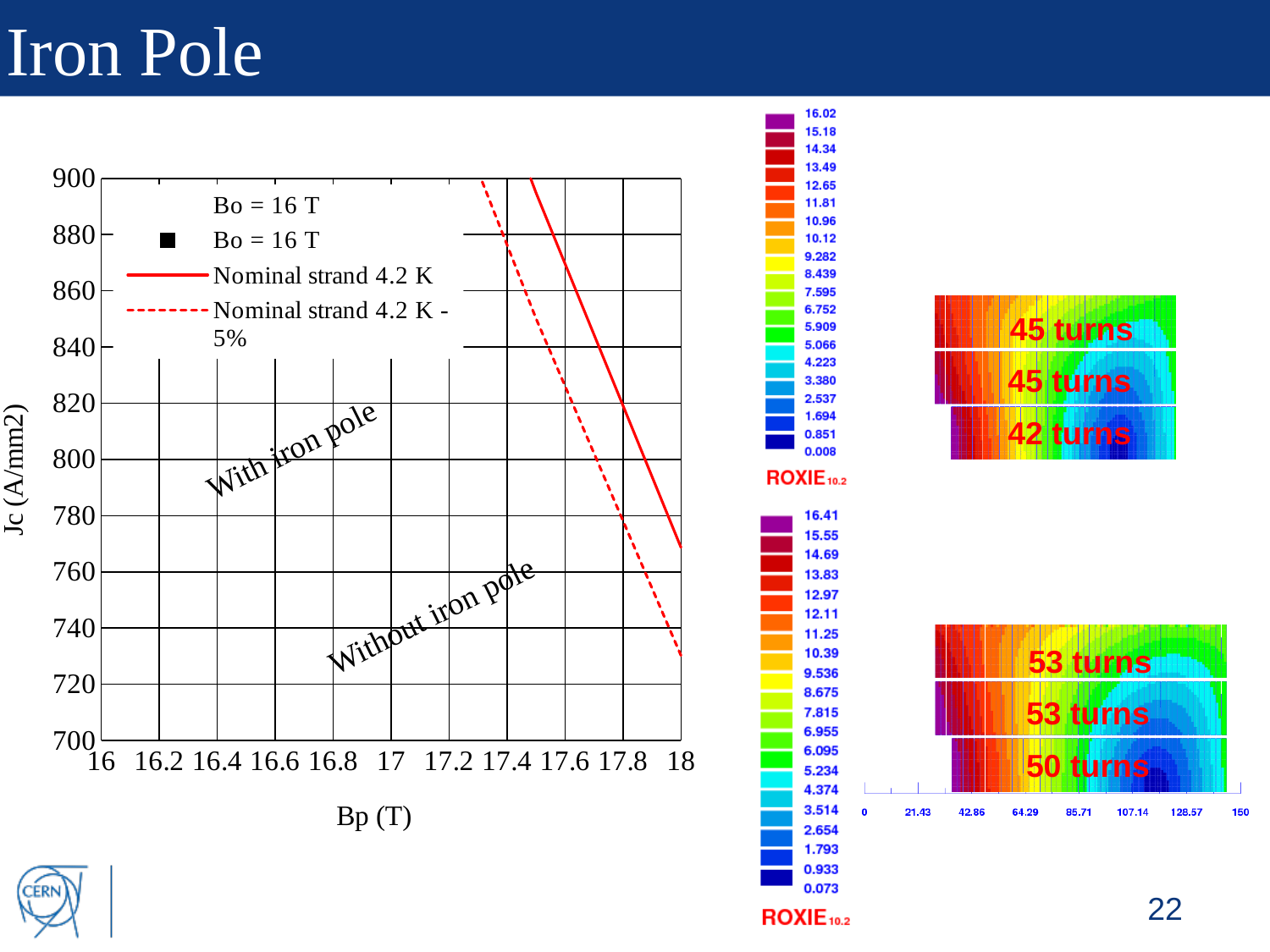
In the Jc versus Bp chart, do the plotted lines rise or fall as Bp increases? fall In the Jc versus Bp chart, is the value of the solid 'Nominal strand 4.2 K' line at Bp = 17.6 T greater or less than 840? greater What is the x-axis label of the chart on the left of the slide? Bp (T) In the Jc versus Bp chart, which line is higher at Bp = 18 T, the solid 'Nominal strand 4.2 K' line or the dashed 'Nominal strand 4.2 K - 5%' line? Nominal strand 4.2 K In the Jc versus Bp chart, which legend entry is drawn with a dashed line? Nominal strand 4.2 K - 5% In the Jc versus Bp chart, is the value of the dashed 'Nominal strand 4.2 K - 5%' line at Bp = 18 T greater or less than 760? less What kind of chart is shown on the left of the slide? line chart How many tick labels are shown on the x axis of the Jc versus Bp chart? 11 How many entries does the legend of the Jc versus Bp chart list? 4 In the Jc versus Bp chart, is the value of the dashed 'Nominal strand 4.2 K - 5%' line at Bp = 17.6 T greater or less than 800? greater